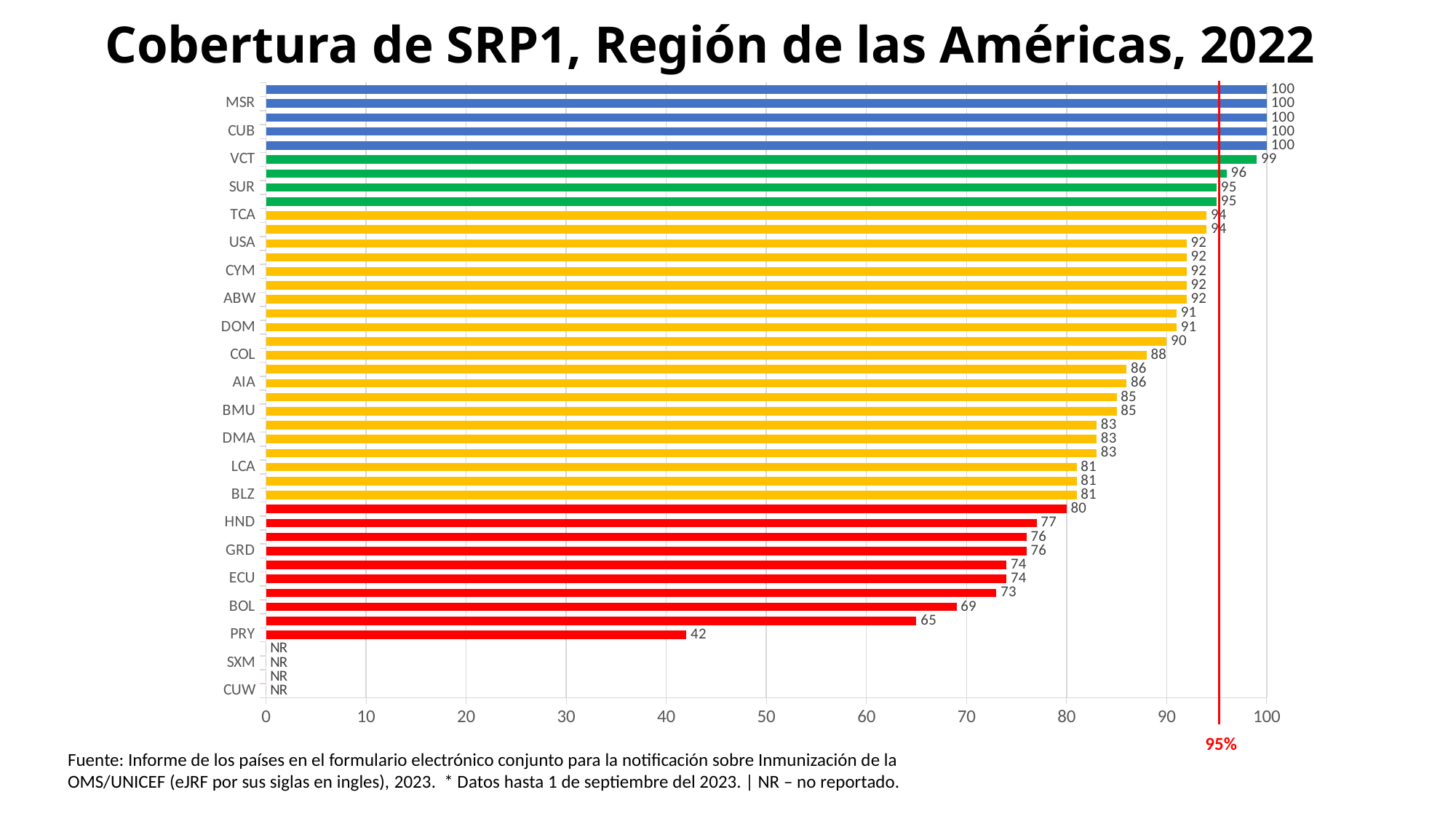
Is the value for COL greater or less than 90? less What is the difference between the coverage values for COL and BOL? 19 Which has a higher coverage value, HND or GRD? HND What is the lowest reported coverage value shown on the chart? 42 What value does the red vertical reference line mark? 95% What is the SRP1 coverage value for VCT? 99 What kind of chart is shown on the slide? bar chart How many bars are marked NR (not reported)? 4 What is the SRP1 coverage value for BOL? 69 What is the SRP1 coverage value for USA? 92 What is the SRP1 coverage value for COL? 88 What is the SRP1 coverage value for MSR? 100